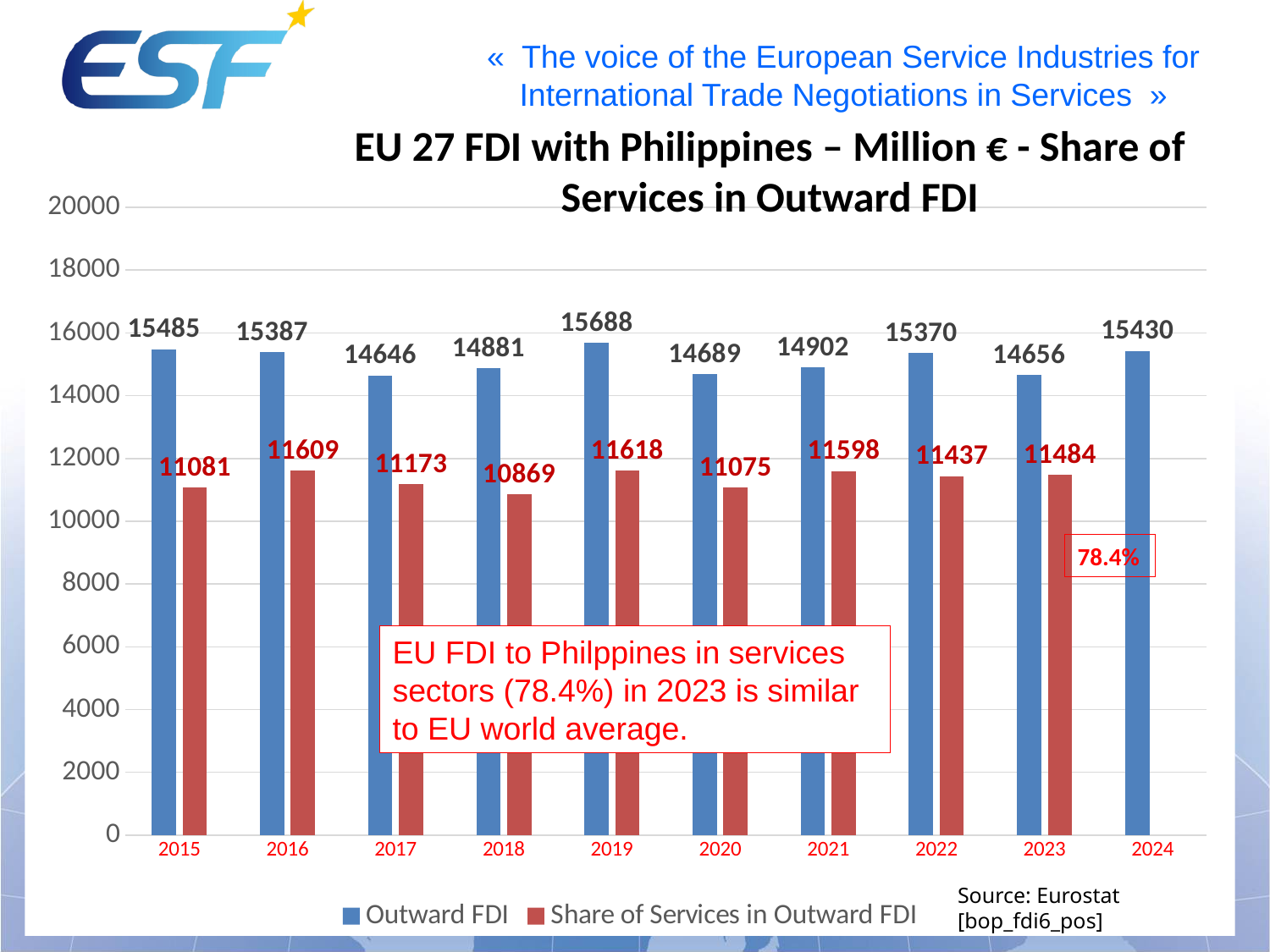
What is the source cited for the chart data? Eurostat [bop_fdi6_pos] What is the Outward FDI value for 2024? 15430 How many series does the legend list? 2 What is the Outward FDI value for 2019? 15688 Is the Share of Services in Outward FDI value for 2021 greater or less than 12000? less What is the difference between Outward FDI and Share of Services in Outward FDI in 2019? 4070 What is the Share of Services in Outward FDI value for 2018? 10869 Which year has the highest Outward FDI value? 2019 Which is larger: the Share of Services in Outward FDI in 2016 or in 2018? 2016 Which year has the lowest Share of Services in Outward FDI value? 2018 How many years are shown on the x axis? 10 What kind of chart is shown on the slide? bar chart